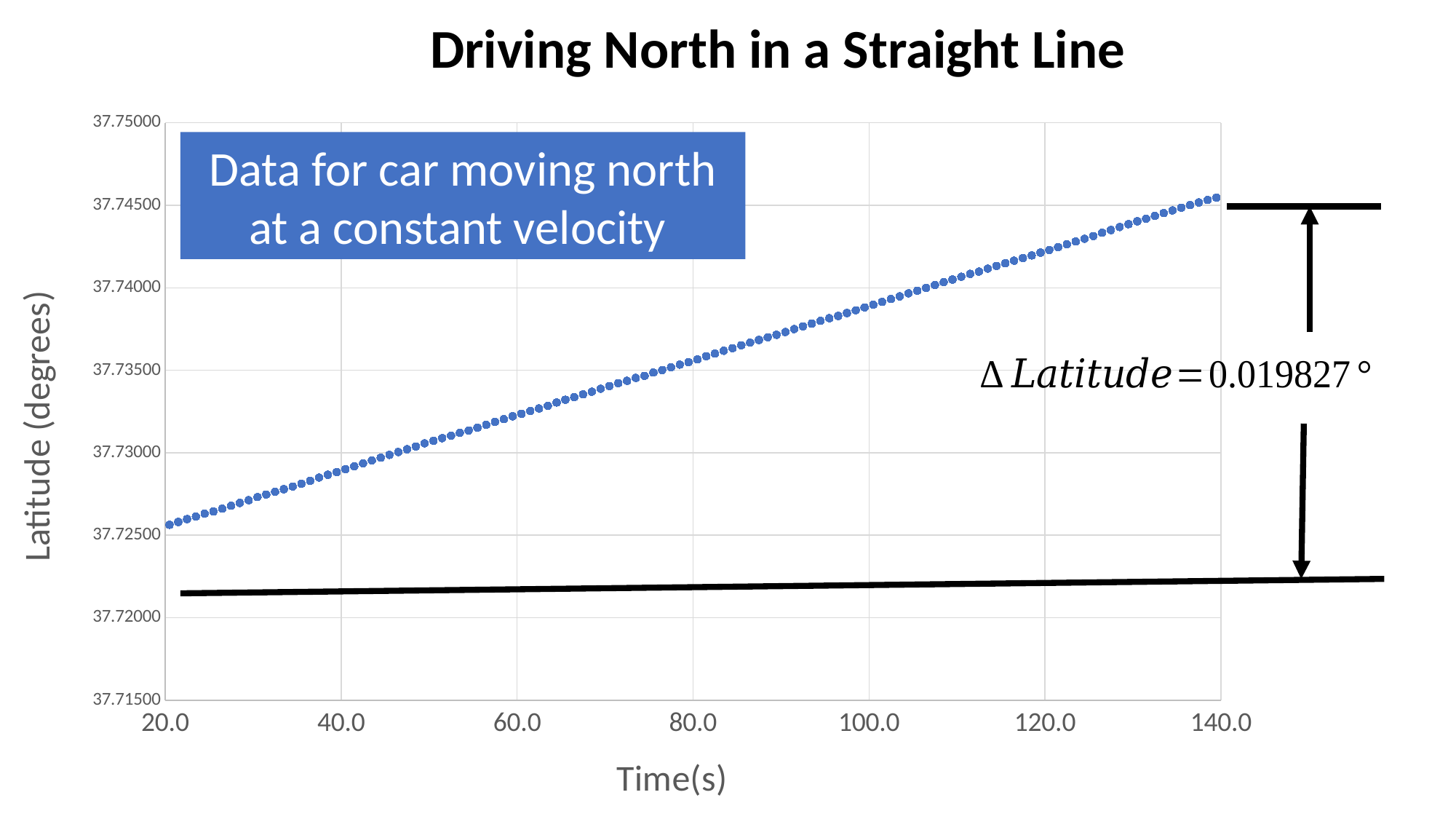
What is the highest tick value shown on the y axis? 37.75000 What value of ΔLatitude is annotated on the chart? 0.019827° What is the title of the chart? Driving North in a Straight Line Is the latitude at time 140.0 s greater or less than 37.74000? greater Is the latitude at time 100.0 s greater or less than 37.73500? greater Which has the higher latitude: the point at 40.0 s or the point at 120.0 s? 120.0 s What kind of chart is shown on the slide? scatter plot What is the label of the x axis? Time(s) Do the latitude values rise or fall as time increases along the x axis? rise At which time shown on the x axis is the latitude highest? 140.0 Is the latitude at time 20.0 s greater or less than 37.73000? less